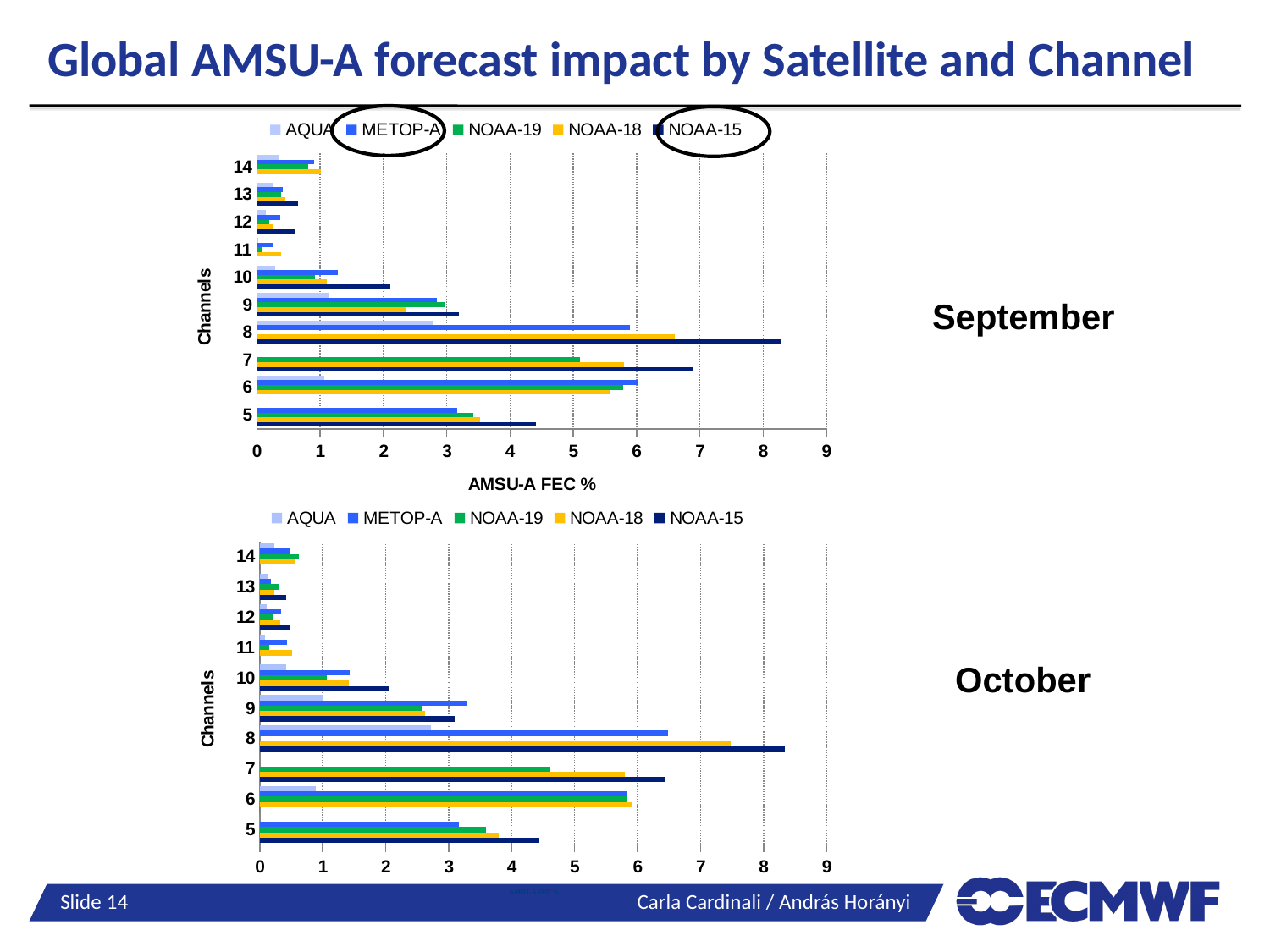
In the September chart, is the NOAA-15 value for channel 7 greater or less than 6? greater In the September chart, which channel has the longest NOAA-15 bar? Channel 8 In the October chart, is the NOAA-18 value for channel 8 greater or less than 7? greater In the October chart, is the NOAA-19 value for channel 7 greater or less than 5? less How many channels are shown on the y axis of the September chart? 10 What is the x-axis title of the September chart? AMSU-A FEC % In the October chart, which is larger for channel 7: the NOAA-15 value or the NOAA-19 value? NOAA-15 In the October chart, which is larger for channel 8: the NOAA-15 value or the METOP-A value? NOAA-15 How many series does the legend of the October chart list? 5 What kind of chart is the September chart? Bar chart Which two legend entries are circled on the September chart? METOP-A and NOAA-15